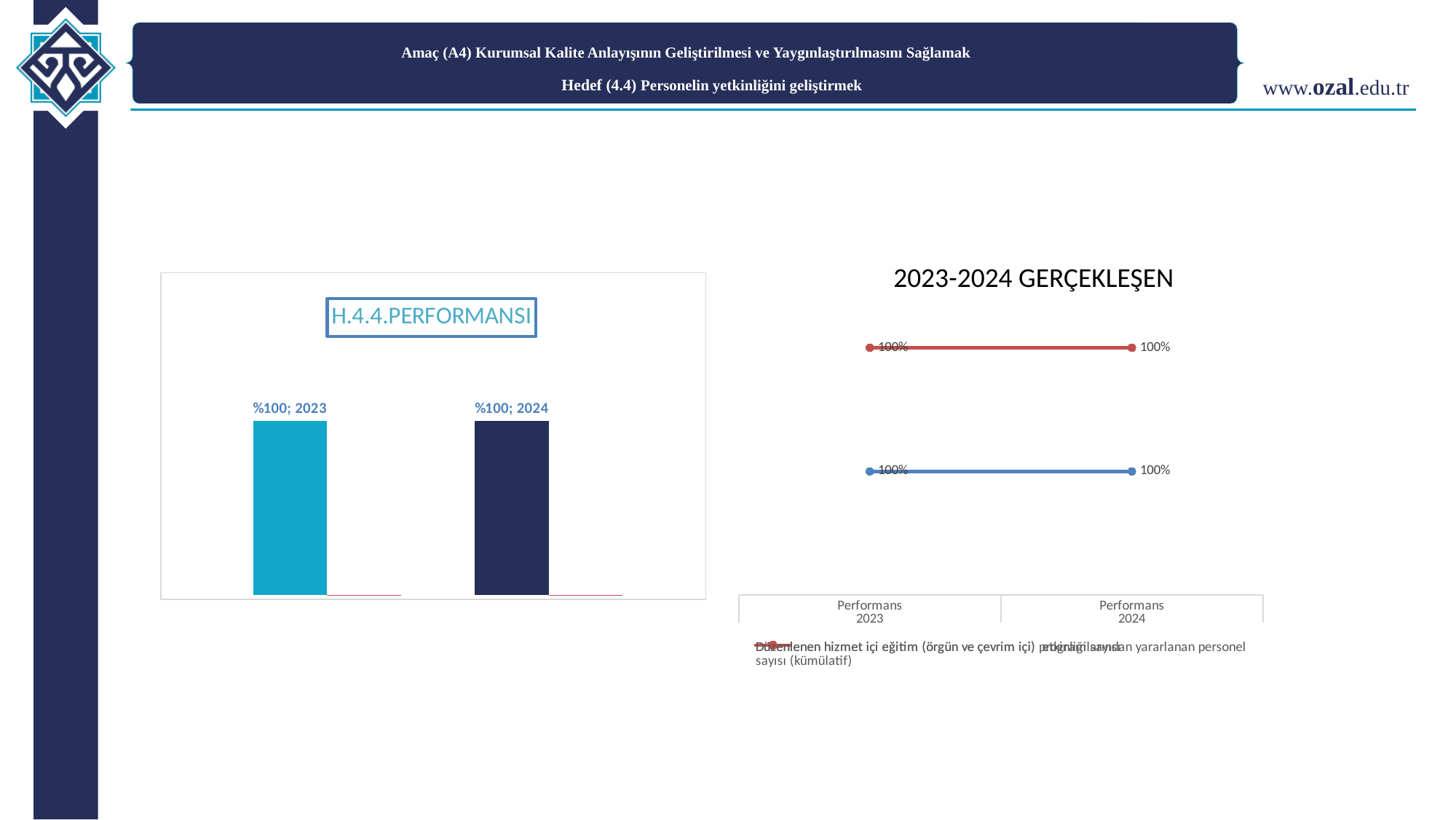
What kind of chart is the H.4.4.PERFORMANSI chart on the left? Bar chart In the H.4.4.PERFORMANSI chart, what is the value shown for 2024? %100 In the H.4.4.PERFORMANSI chart, what is the value shown for 2023? %100 In the H.4.4.PERFORMANSI chart, what is the difference between the 2023 and 2024 values? 0 How many series are plotted in the 2023-2024 GERÇEKLEŞEN chart? 2 How many bars are plotted in the H.4.4.PERFORMANSI chart? 2 In the H.4.4.PERFORMANSI chart, is the value for 2024 higher than, lower than, or equal to the value for 2023? Equal What is the title of the chart on the right side of the slide? 2023-2024 GERÇEKLEŞEN In the 2023-2024 GERÇEKLEŞEN chart, what value does the red series show for Performans 2024? 100% What kind of chart is the 2023-2024 GERÇEKLEŞEN chart? Line chart In the 2023-2024 GERÇEKLEŞEN chart, what value does the blue series show for Performans 2023? 100% In the 2023-2024 GERÇEKLEŞEN chart, do the values rise, fall, or stay flat from Performans 2023 to Performans 2024? Stay flat